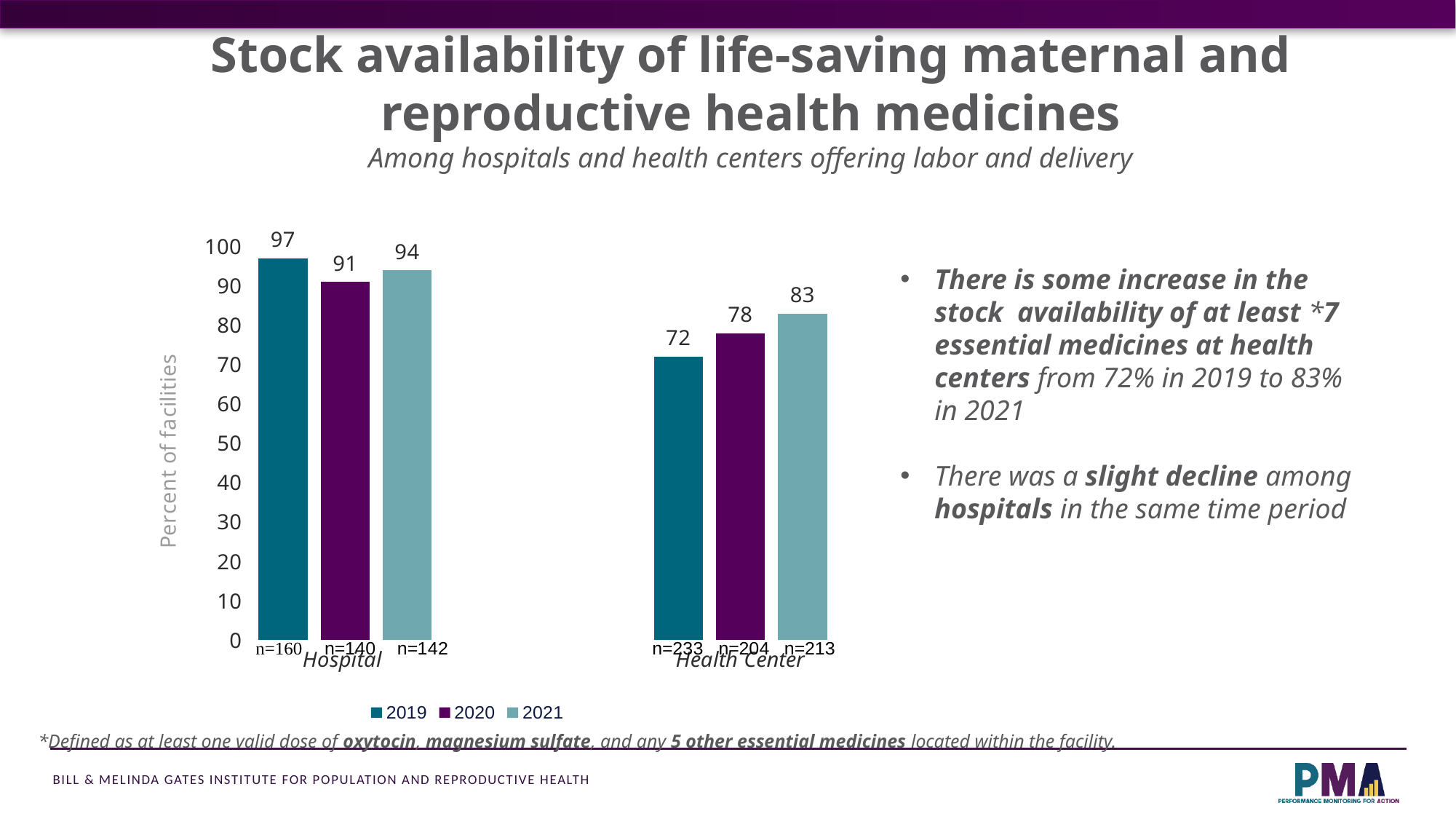
What kind of chart is shown on the slide? Bar chart Which year has the lowest value for Hospital? 2020 Do the Health Center values rise or fall from 2019 to 2021? Rise What is the value for Health Center in 2021? 83 How many series does the legend list? 3 Which is larger, the Hospital value in 2021 or the Health Center value in 2021? Hospital What is the label of the vertical axis? Percent of facilities Which year has the highest value for Health Center? 2021 What is the difference between the Hospital and Health Center values in 2019? 25 What is the value for Health Center in 2020? 78 What is the value for Hospital in 2020? 91 What is the value for Hospital in 2019? 97